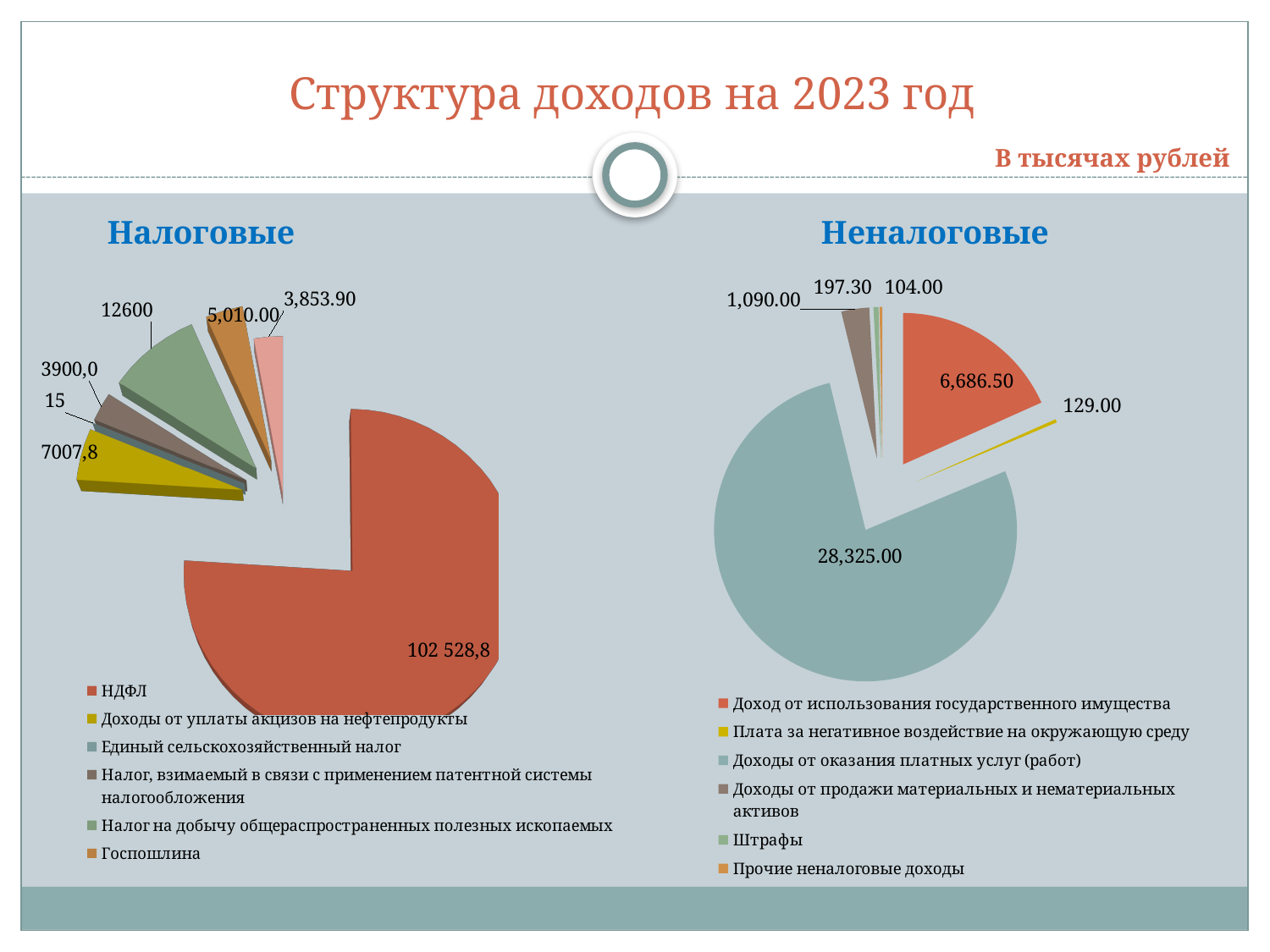
On the Налоговые chart, what is the difference between Налог на добычу общераспространенных полезных ископаемых and Доходы от уплаты акцизов на нефтепродукты? 5592,2 On the Неналоговые chart, what is the difference between Доход от использования государственного имущества and Плата за негативное воздействие на окружающую среду? 6,557.50 On the Неналоговые chart, which is larger: Плата за негативное воздействие на окружающую среду or Прочие неналоговые доходы? Плата за негативное воздействие на окружающую среду On the Налоговые chart, which category has the smallest value? Единый сельскохозяйственный налог What kind of chart is the Налоговые chart? Pie chart How many entries does the legend of the Неналоговые chart list? 6 On the Неналоговые chart, what is the value for Доходы от оказания платных услуг (работ)? 28,325.00 On the Неналоговые chart, what is the value for Штрафы? 197.30 On the Неналоговые chart, which category has the largest value? Доходы от оказания платных услуг (работ) On the Налоговые chart, what is the value for НДФЛ? 102 528,8 On the Налоговые chart, what is the value for Налог на добычу общераспространенных полезных ископаемых? 12600 On the Налоговые chart, what is the value for Госпошлина? 5,010.00